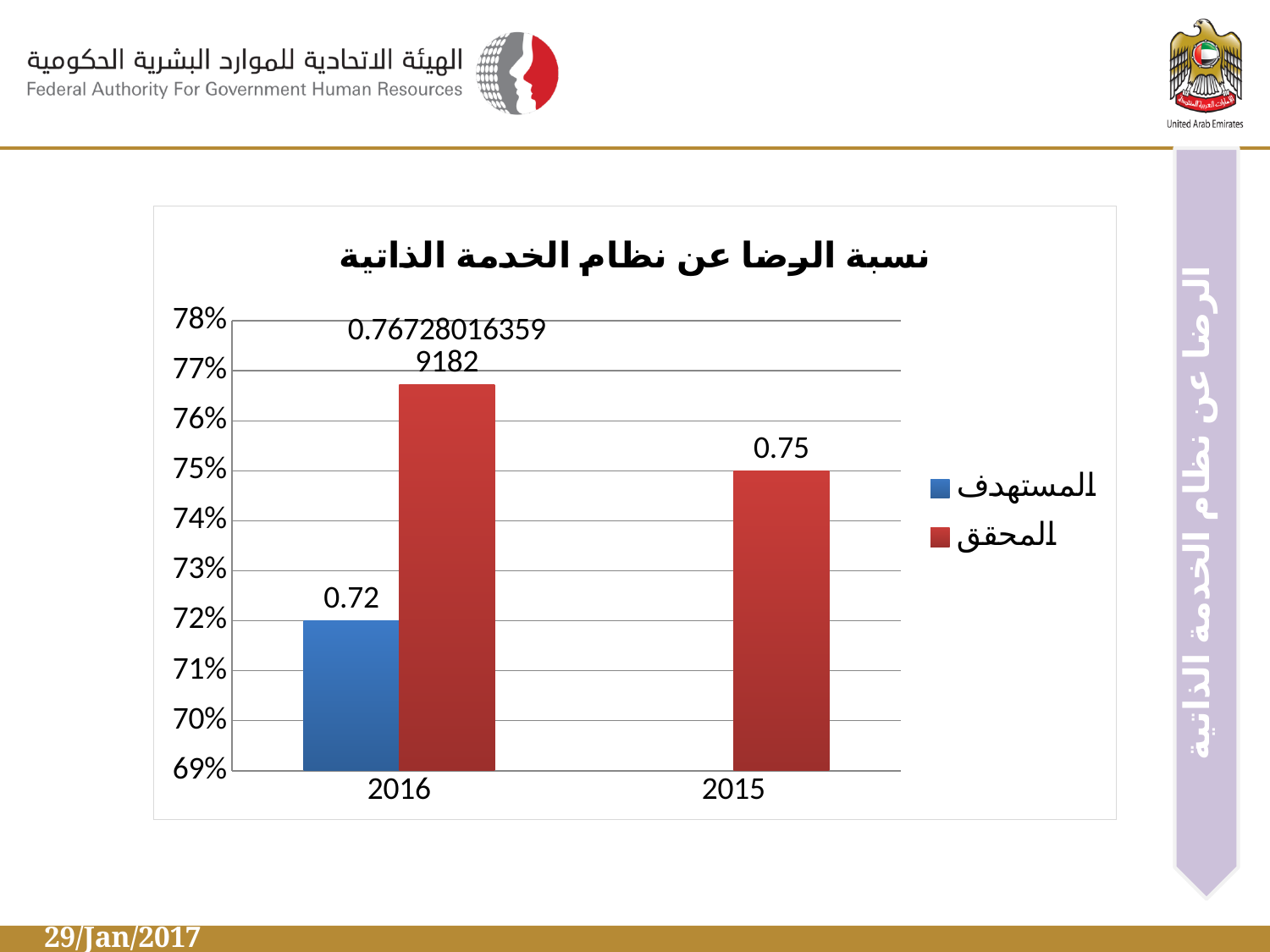
How many years are shown on the x axis? 2 Is the المحقق value for 2016 greater or less than 76%? greater Which bar on the chart is the tallest? المحقق for 2016 What is the data label on the المحقق (achieved) bar for 2015? 0.75 What is the difference between the المحقق value for 2015 and the المستهدف value for 2016? 0.03 Which bar on the chart is the shortest? المستهدف for 2016 What is the value of the المستهدف (target) bar for 2016? 0.72 What kind of chart is shown on the slide? Bar chart What is the title of the chart? نسبة الرضا عن نظام الخدمة الذاتية What is the data label on the المحقق (achieved) bar for 2016? 0.767280163599182 How many series does the legend list? 2 Which is larger: the المحقق value for 2016 or the المحقق value for 2015? المحقق for 2016